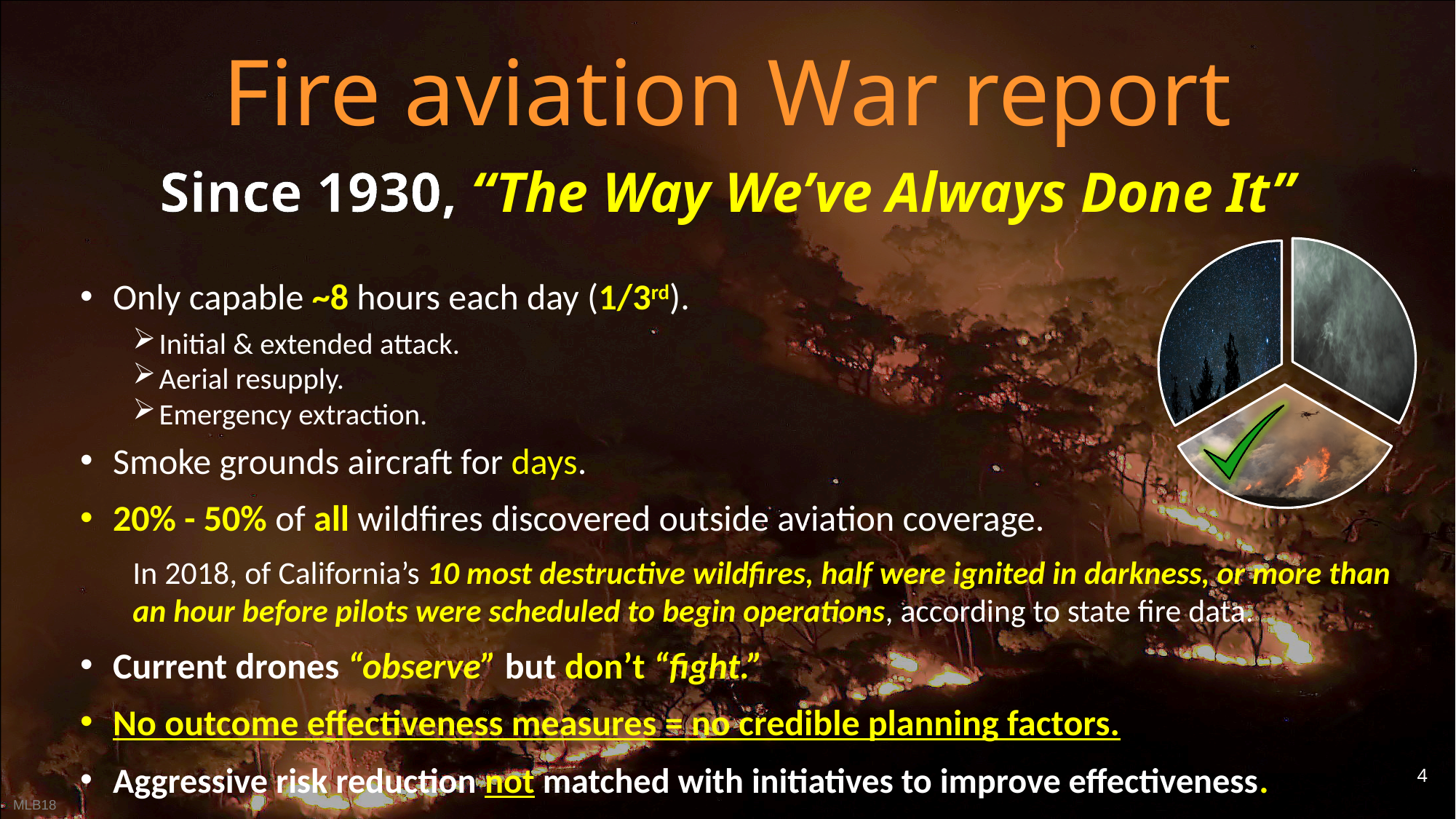
According to the slide, what share of each day does the checked slice of the pie chart represent? 1/3rd Are the three slices of the pie chart on the right side of the slide equal in size? yes What kind of chart is shown on the right side of the slide? pie chart In the pie chart on the right side of the slide, which slice is marked with a green check mark? the bottom slice (daytime fire with helicopter) How many slices does the pie chart on the right side of the slide have? 3